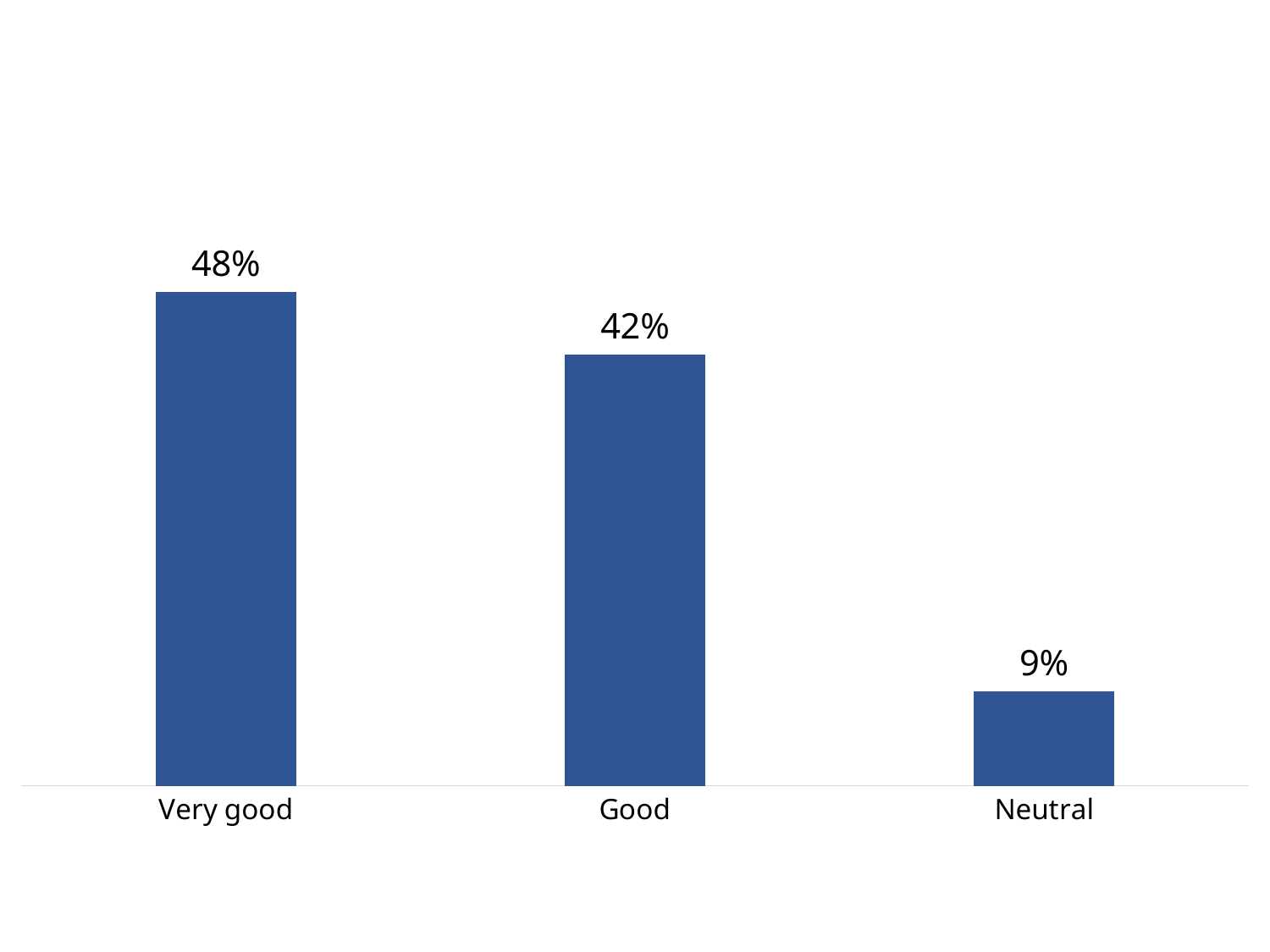
What is the value for Good? 42% What kind of chart is this? Bar chart Which category has the lowest value? Neutral What colour are the bars? Blue How many categories are shown on the chart? 3 Do the values rise or fall from left to right across the categories? Fall What is the value for Neutral? 9% Which is larger, the value for Good or the value for Neutral? Good What is the value for Very good? 48% What is the difference between the values for Very good and Good? 6% Which category has the highest value? Very good What is the difference between the values for Good and Neutral? 33%